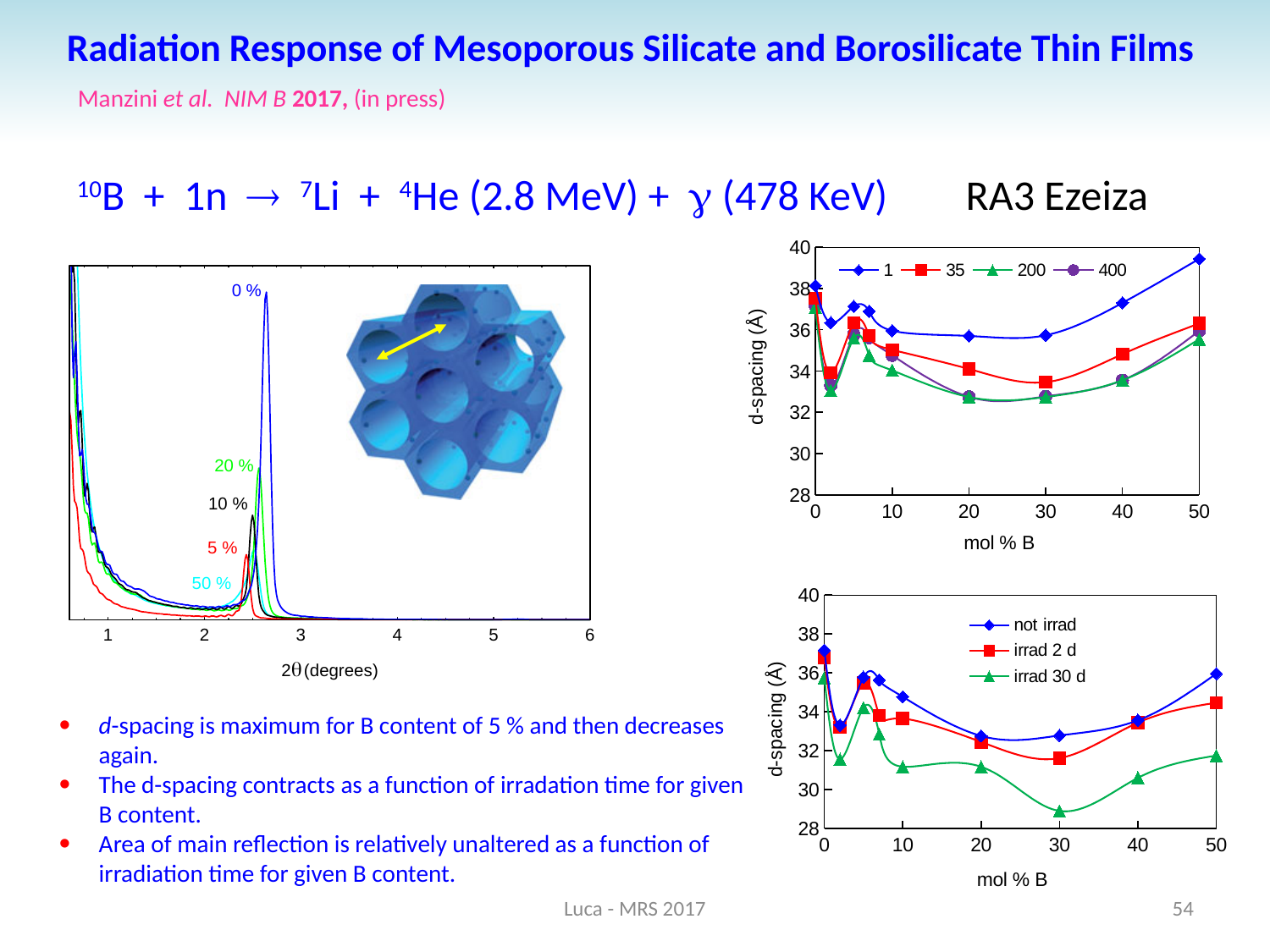
In the bottom-right chart, is the value of 'irrad 30 d' at 30 mol % B greater or less than 30? less In the left chart (intensity vs 2θ), which labelled curve has the highest peak? 0 % In the bottom-right chart (d-spacing vs mol % B), how many series does the legend list? 3 In the bottom-right chart, at 30 mol % B, which series has the larger d-spacing: 'not irrad' or 'irrad 30 d'? not irrad In the bottom-right chart, does the 'irrad 30 d' d-spacing rise or fall from 10 to 30 mol % B? fall In the top-right chart, does the d-spacing of series 1 rise or fall from 20 to 50 mol % B? rise In the top-right chart, is the value of series 200 at 20 mol % B greater or less than 34? less In the top-right chart, at 50 mol % B, which series has the larger d-spacing: 1 or 35? 1 What kind of chart is the top-right chart of d-spacing versus mol % B? line chart In the top-right chart (d-spacing vs mol % B), how many series does the legend list? 4 In the left chart (intensity vs 2θ), how many labelled curves are shown? 5 In the top-right chart, is the value of series 1 at 50 mol % B greater or less than 38? greater